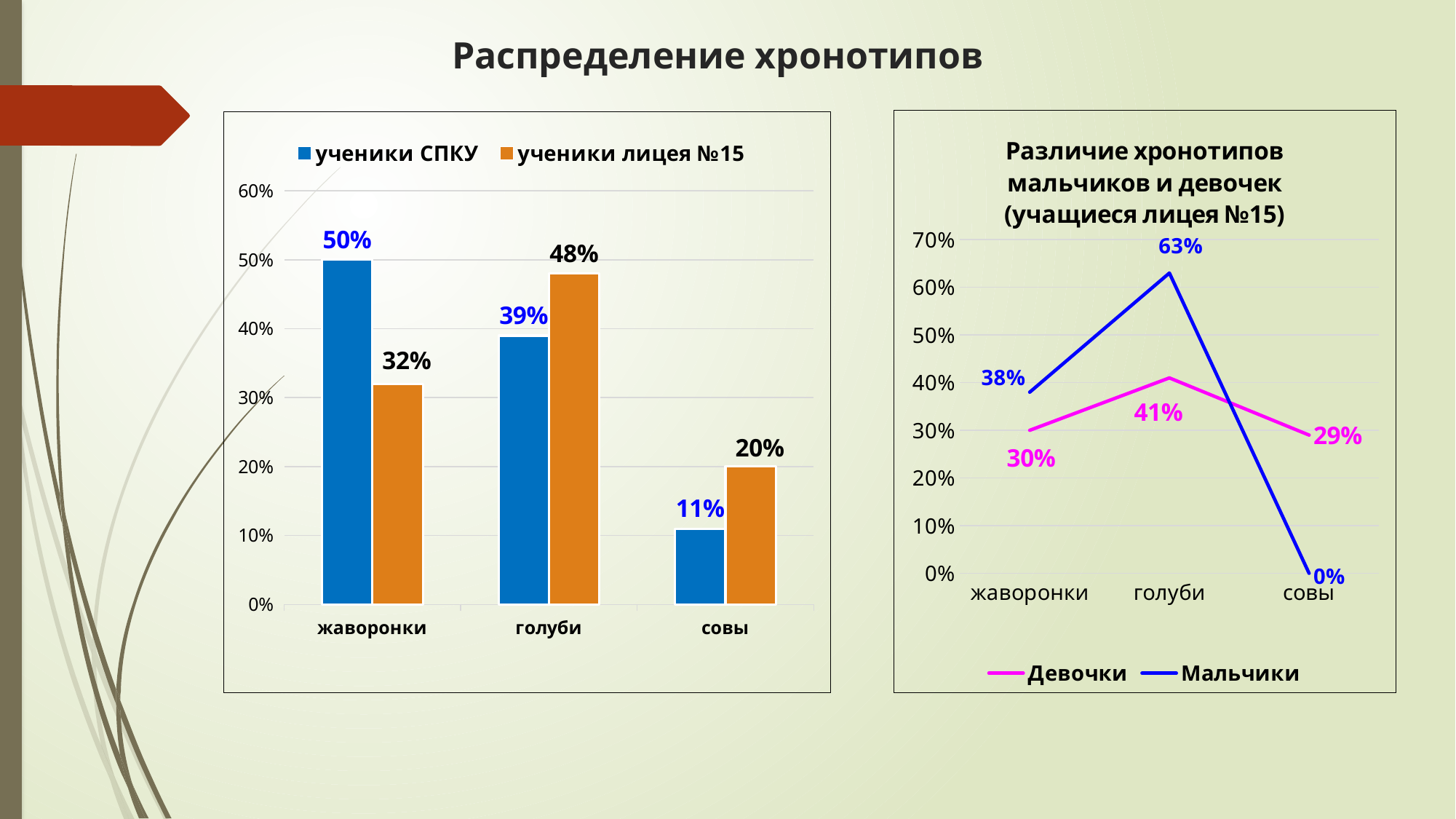
In the chart 'Различие хронотипов мальчиков и девочек', what is the value for Мальчики in the голуби category? 63% In the left bar chart, which category has the lowest value for ученики СПКУ? совы What kind of chart is 'Различие хронотипов мальчиков и девочек'? line chart In the left bar chart, what is the value for ученики СПКУ in the жаворонки category? 50% In the chart 'Различие хронотипов мальчиков и девочек', what is the value for Девочки in the совы category? 29% In the left bar chart, which is larger in the совы category: ученики СПКУ or ученики лицея №15? ученики лицея №15 How many series does the legend of the left bar chart list? 2 In the left bar chart, what is the value for ученики лицея №15 in the голуби category? 48% In the chart 'Различие хронотипов мальчиков и девочек', which category has the highest value for Девочки? голуби What kind of chart is the left chart on the slide? bar chart In the chart 'Различие хронотипов мальчиков и девочек', what is the difference between Мальчики and Девочки in the голуби category? 22% In the left bar chart, what is the difference between ученики СПКУ and ученики лицея №15 in the жаворонки category? 18%